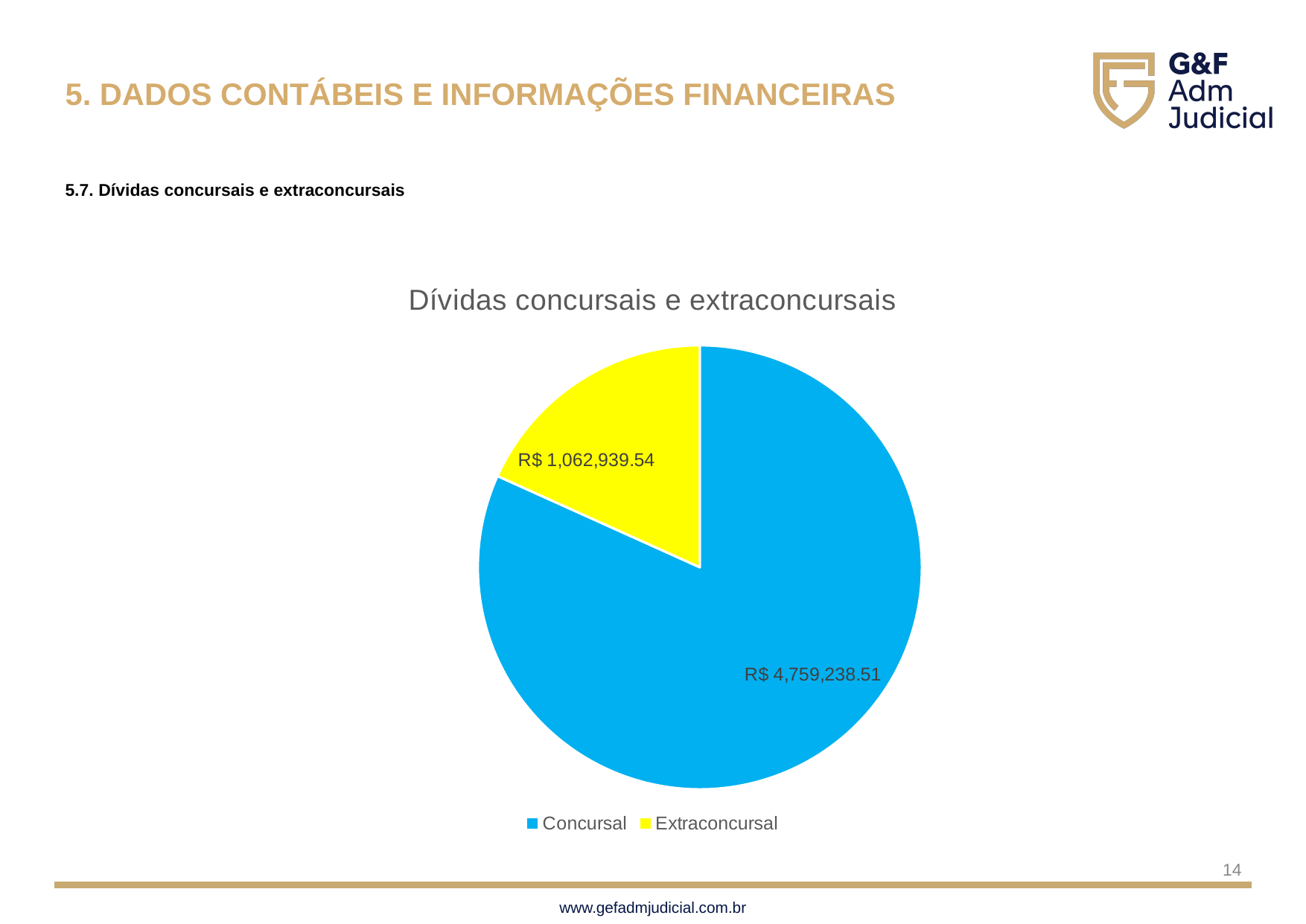
What is the difference between the Concursal and Extraconcursal values? R$ 3,696,298.97 What is the title of the chart? Dívidas concursais e extraconcursais Which category has the largest slice of the pie? Concursal What is the total of the two slices in the pie chart? R$ 5,822,178.05 What type of chart is shown on the slide? Pie chart What is the value of the Extraconcursal slice? R$ 1,062,939.54 How many slices does the pie chart have? 2 Which is larger, the Concursal value or the Extraconcursal value? Concursal How many entries does the legend list? 2 Which category has the smallest slice of the pie? Extraconcursal What colour is the Extraconcursal slice? Yellow What is the value of the Concursal slice? R$ 4,759,238.51